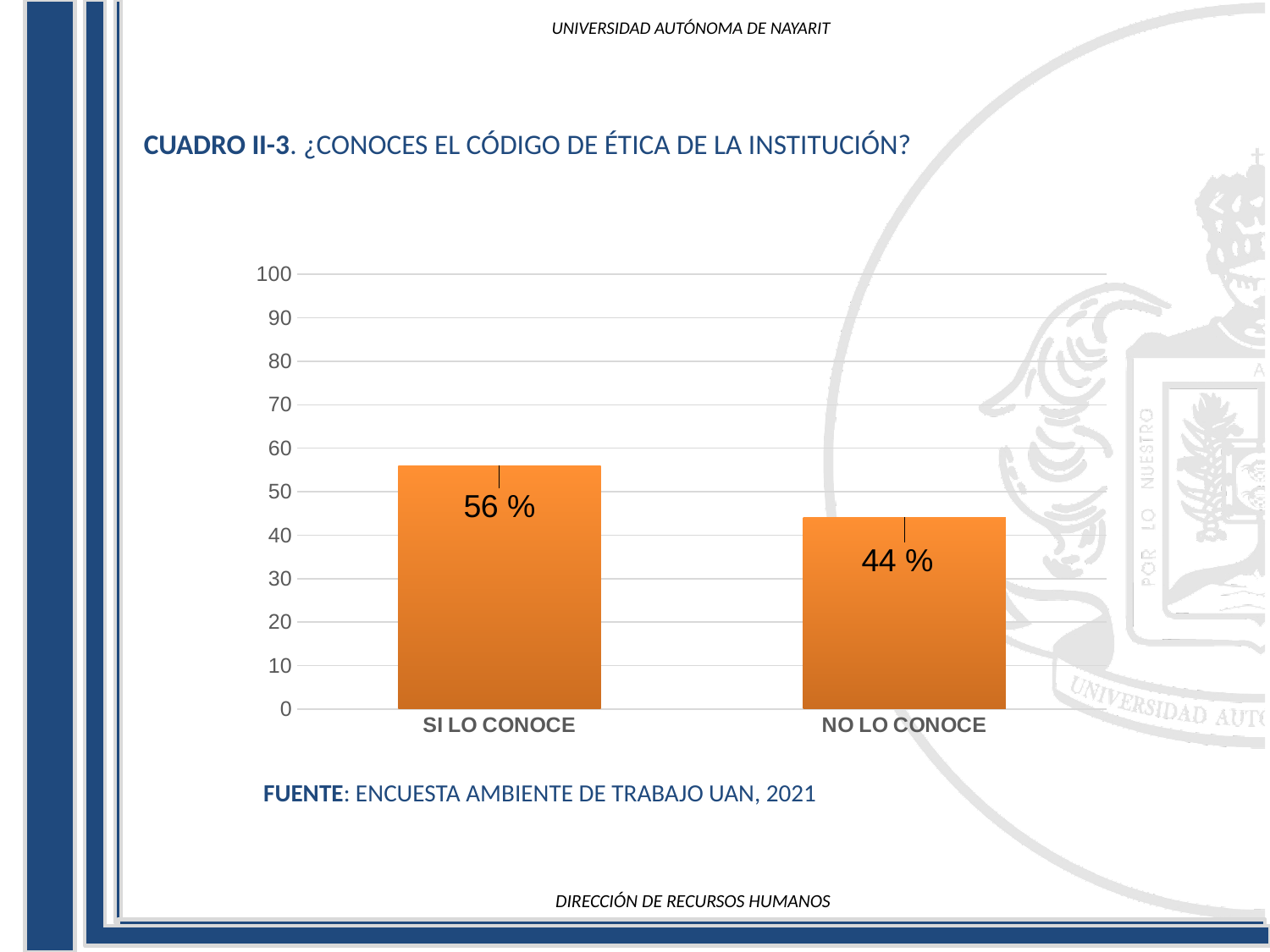
What is the difference between the values for SI LO CONOCE and NO LO CONOCE? 12 % What is the value for NO LO CONOCE? 44 % What source is cited below the chart? ENCUESTA AMBIENTE DE TRABAJO UAN, 2021 What is the value for SI LO CONOCE? 56 % What kind of chart is shown on the slide? bar chart Is the value for NO LO CONOCE greater or less than 50? less How many categories are shown in the chart? 2 Which is larger, the value for SI LO CONOCE or NO LO CONOCE? SI LO CONOCE Which category has the lowest value? NO LO CONOCE Which category has the highest value? SI LO CONOCE Is the value for SI LO CONOCE greater or less than 50? greater What is the maximum value shown on the vertical axis? 100